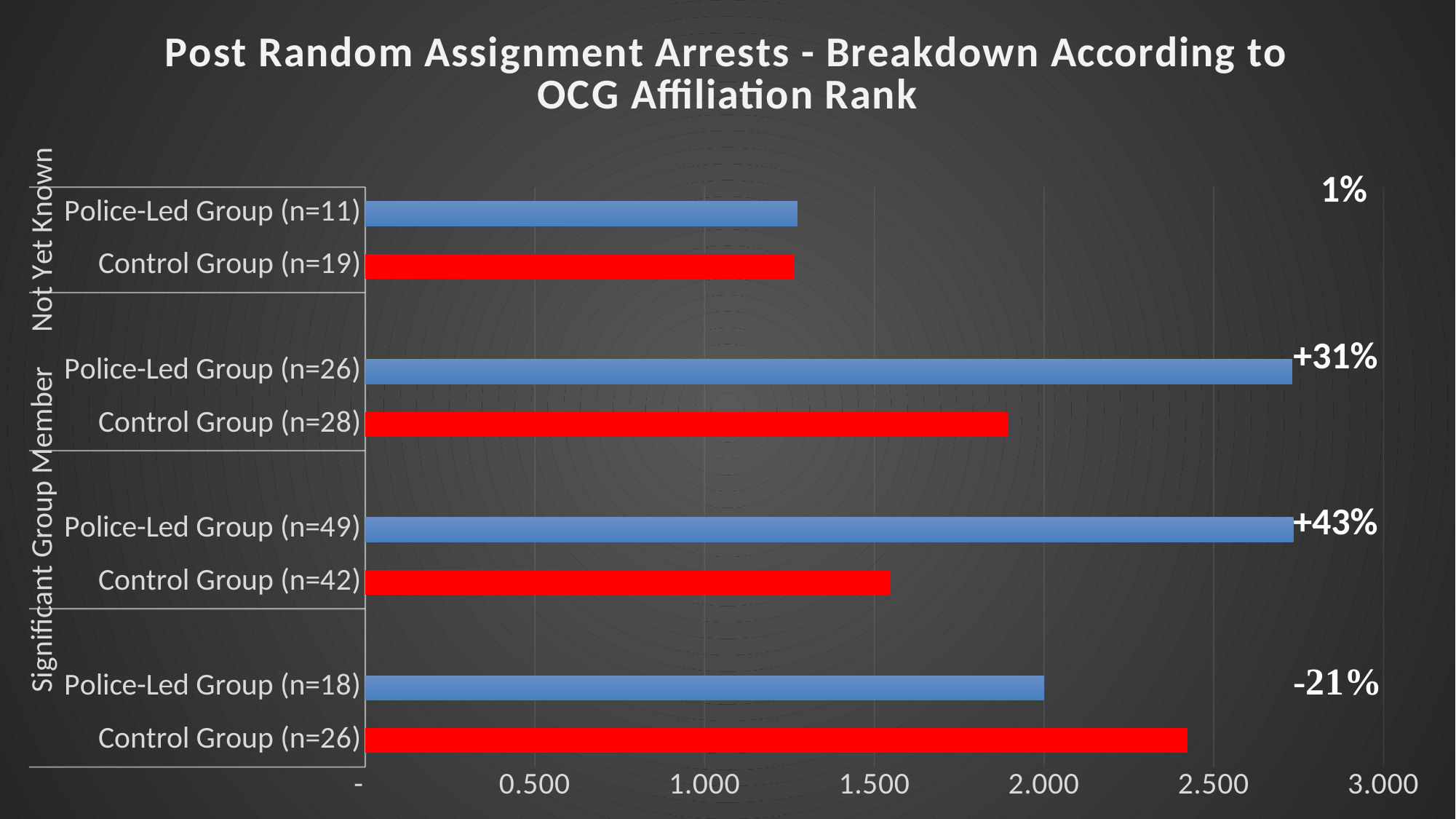
Which bar is longer: Police-Led Group (n=18) or Control Group (n=26)? Control Group (n=26) Is the value for Control Group (n=28) greater or less than 1.500? greater What percentage annotation is shown next to the Police-Led Group (n=49) bar? +43% Is the value for Police-Led Group (n=26) greater or less than 2.500? greater What kind of chart is shown on the slide? bar chart Is the value for Control Group (n=42) greater or less than 2.000? less Which bar is longer: Police-Led Group (n=49) or Control Group (n=42)? Police-Led Group (n=49) What is the title of the chart? Post Random Assignment Arrests - Breakdown According to OCG Affiliation Rank Which bar is longer: Police-Led Group (n=26) or Control Group (n=28)? Police-Led Group (n=26) How many bars are plotted in the chart? 8